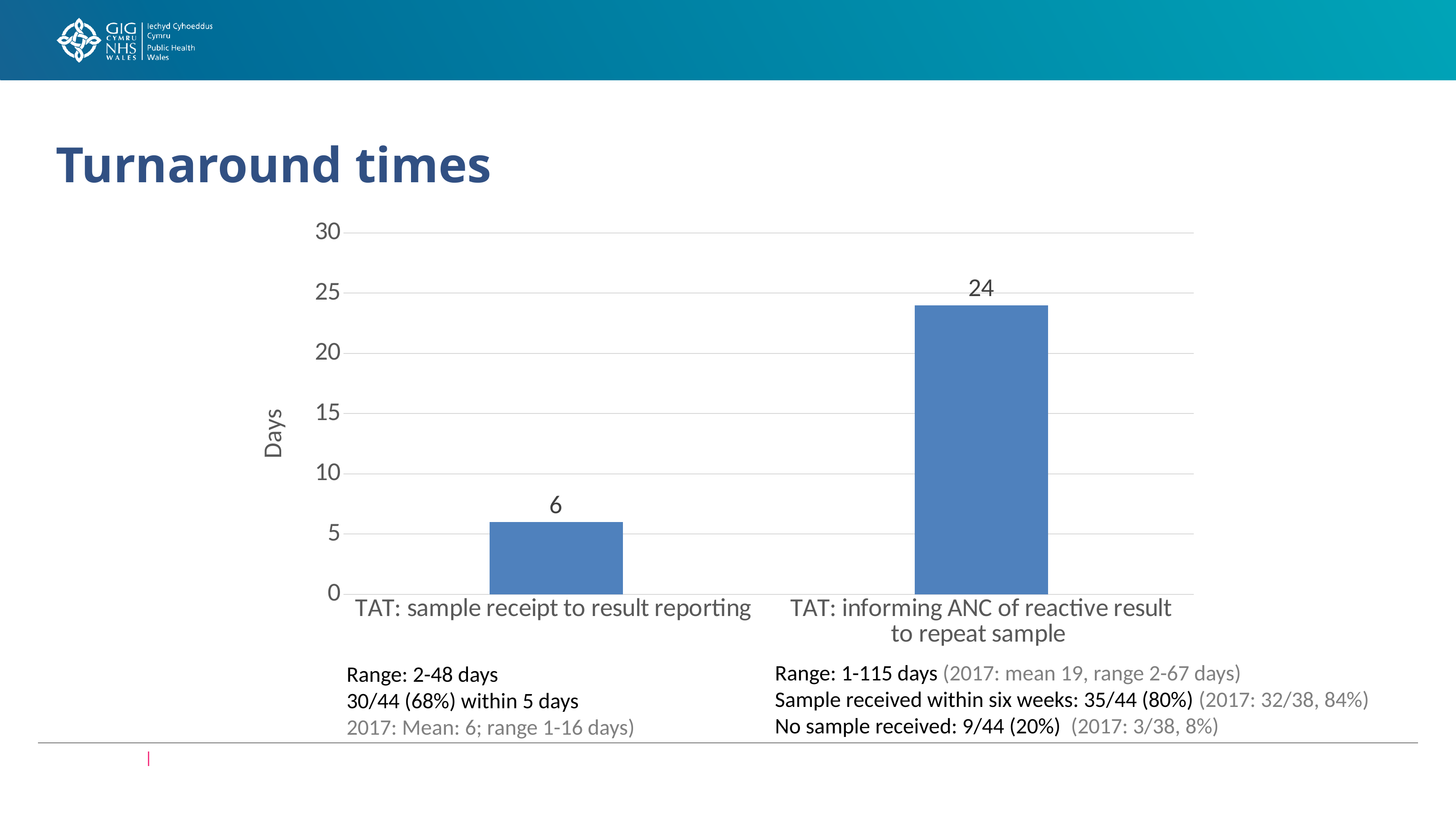
What is the value for 'TAT: informing ANC of reactive result to repeat sample'? 24 Which category has the lowest value? TAT: sample receipt to result reporting What kind of chart is shown on the slide? bar chart What is the difference between the value for 'TAT: informing ANC of reactive result to repeat sample' and the value for 'TAT: sample receipt to result reporting'? 18 What is the highest value shown on the vertical axis? 30 Is the value for 'TAT: informing ANC of reactive result to repeat sample' greater or less than 20? greater Which category has the highest value? TAT: informing ANC of reactive result to repeat sample Which is larger: the value for 'TAT: sample receipt to result reporting' or the value for 'TAT: informing ANC of reactive result to repeat sample'? TAT: informing ANC of reactive result to repeat sample How many categories are shown on the chart? 2 What is the value for 'TAT: sample receipt to result reporting'? 6 Is the value for 'TAT: sample receipt to result reporting' greater or less than 10? less What is the label of the vertical axis? Days